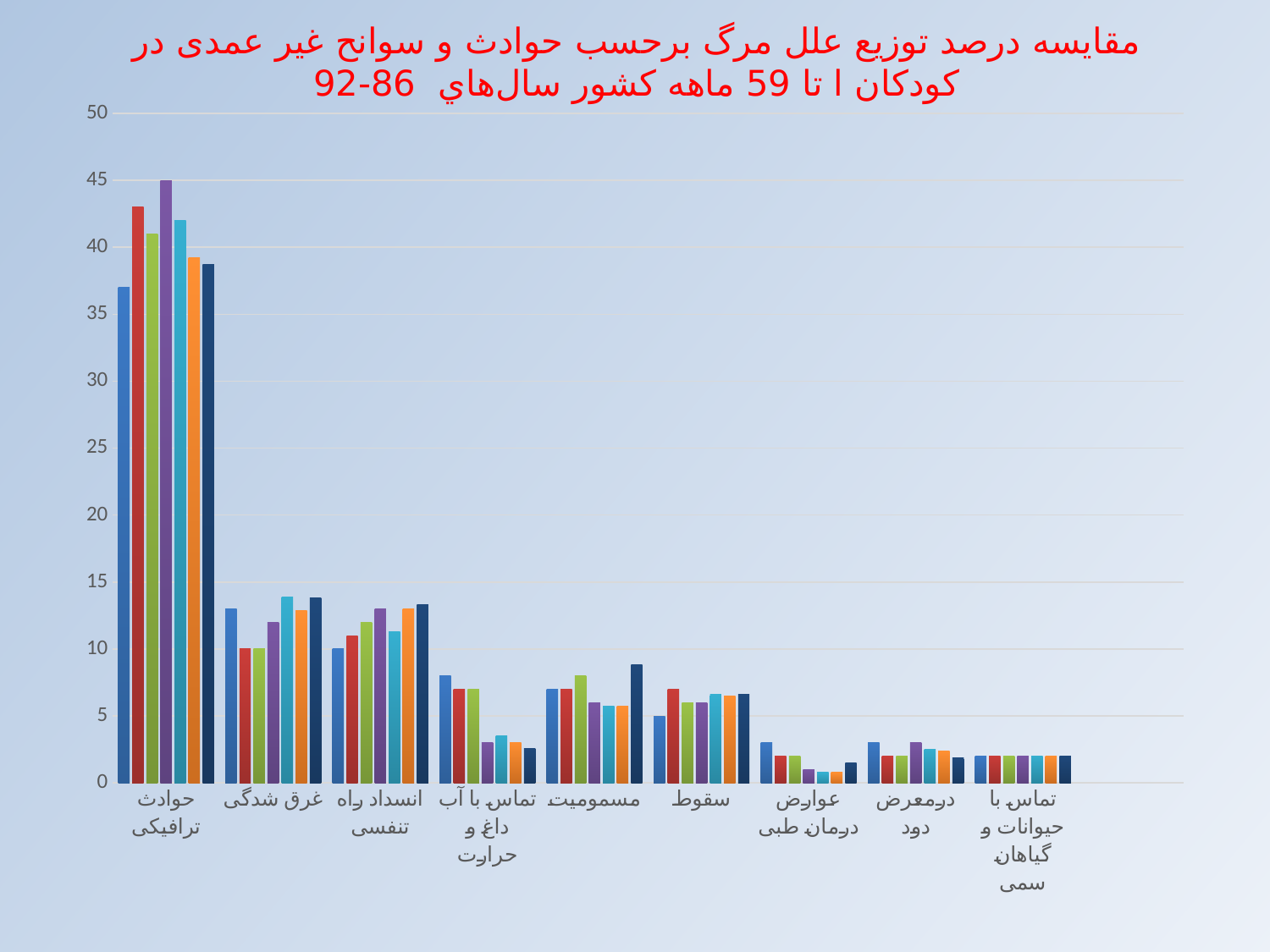
Which category has the highest values in the chart? حوادث ترافیکی How many categories are shown on the x axis of the chart? 9 Are the values for تماس با حیوانات و گیاهان سمی greater or less than 5? less Which category has larger values, انسداد راه تنفسی or تماس با آب داغ و حرارت? انسداد راه تنفسی Do the values generally rise or fall moving from left to right along the x axis? fall Are the values for سقوط greater or less than 10? less Is the value of the purple bar for حوادث ترافیکی greater or less than 40? greater What kind of chart is shown on the slide? bar chart Which category has larger values, حوادث ترافیکی or غرق شدگی? حوادث ترافیکی How many bars are plotted for each category in the chart? 7 What is the title of the chart? مقایسه درصد توزیع علل مرگ برحسب حوادث و سوانح غیر عمدی در کودکان ا تا 59 ماهه کشور سال‌هاي 92-86